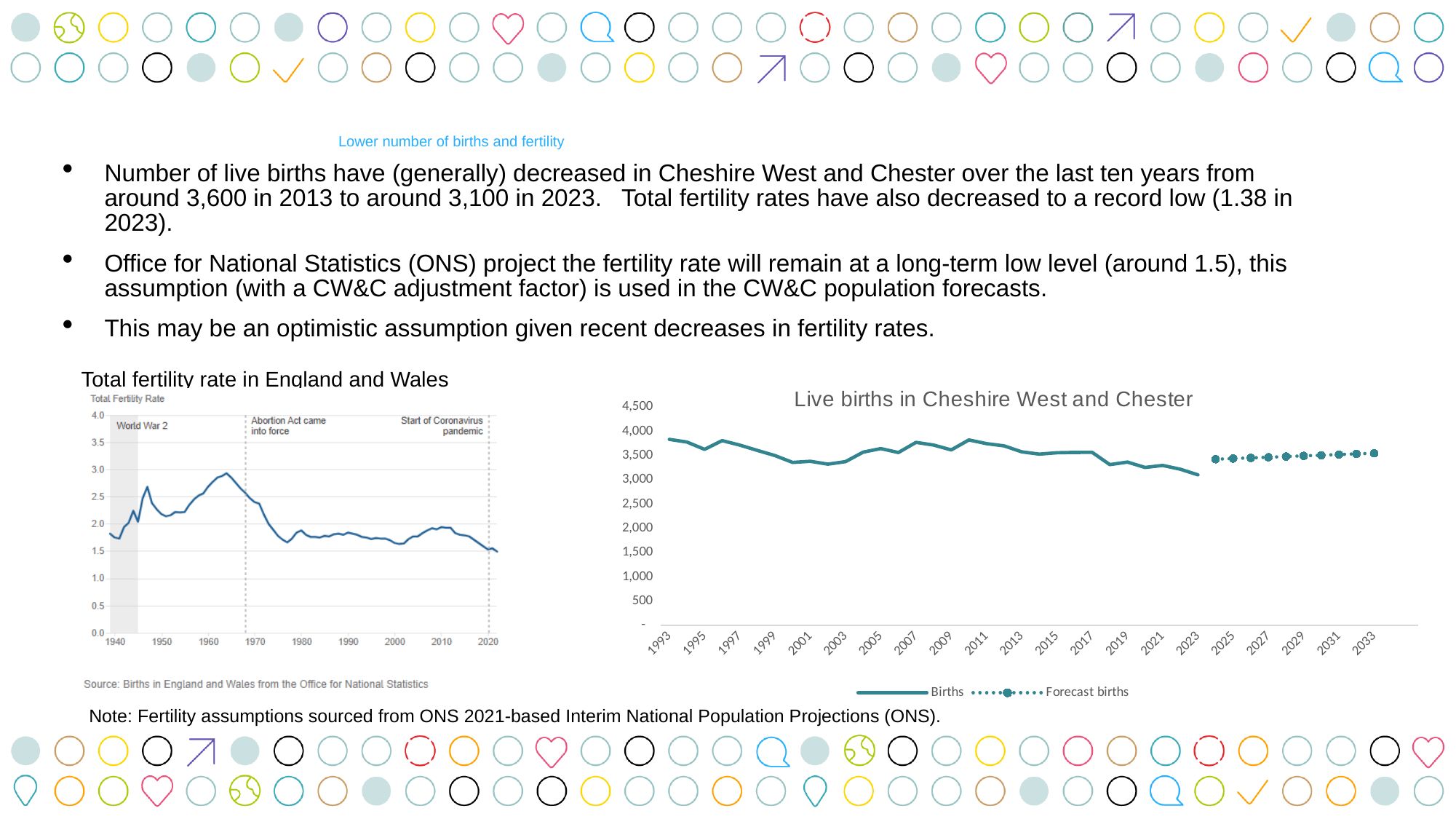
In the 'Total fertility rate in England and Wales' chart, is the value at the peak around 1964 greater or less than 2.5? greater What type of chart is the 'Live births in Cheshire West and Chester' chart? line chart In the 'Live births in Cheshire West and Chester' chart, is the value for 1993 greater or less than 3,500? greater In the 'Live births in Cheshire West and Chester' chart, is the forecast value for 2033 greater or less than 4,000? less In the 'Live births in Cheshire West and Chester' chart, what are the two series named in the legend? Births and Forecast births In the 'Total fertility rate in England and Wales' chart, what three events are annotated on the chart? World War 2, Abortion Act came into force, Start of Coronavirus pandemic In the 'Live births in Cheshire West and Chester' chart, which is larger, the Births value for 1993 or the Births value for 2023? 1993 In the 'Live births in Cheshire West and Chester' chart, do the Births values generally rise or fall between 1993 and 2023? fall What type of chart is the 'Total fertility rate in England and Wales' chart? line chart How many series does the legend of the 'Live births in Cheshire West and Chester' chart list? 2